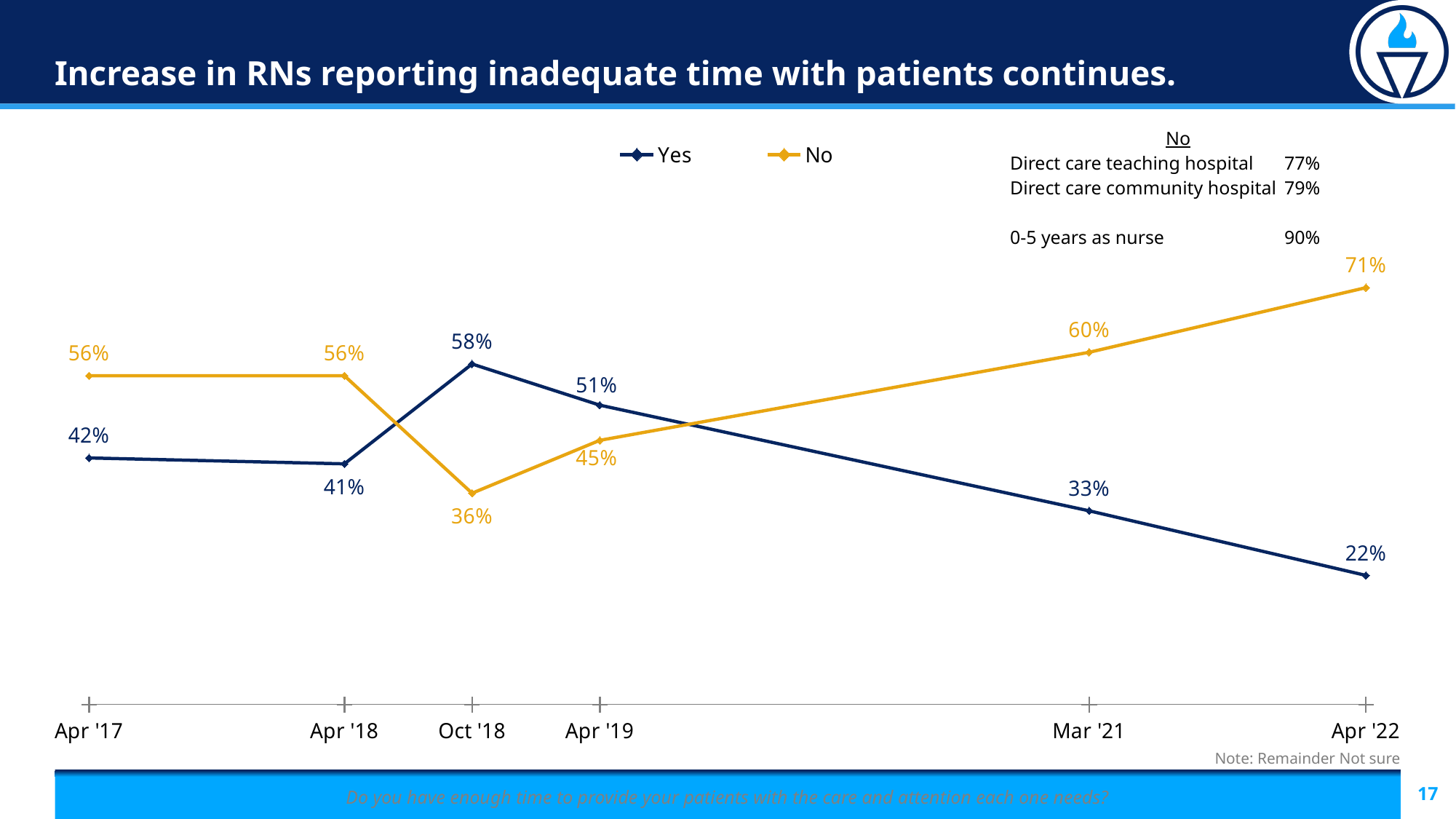
How many dates are plotted on the x axis? 6 What is the difference between the No and Yes values at Apr '22? 49 percentage points At which date is the Yes series lowest? Apr '22 What is the value of the Yes series at Oct '18? 58% Does the Yes series rise or fall from Oct '18 to Apr '22? Fall At Apr '19, which series has the larger value, Yes or No? Yes What is the value of the Yes series at Apr '22? 22% At which date is the No series highest? Apr '22 What is the value of the No series at Mar '21? 60% What kind of chart is shown on the slide? Line chart How many series does the legend list? 2 What is the value of the No series at Oct '18? 36%